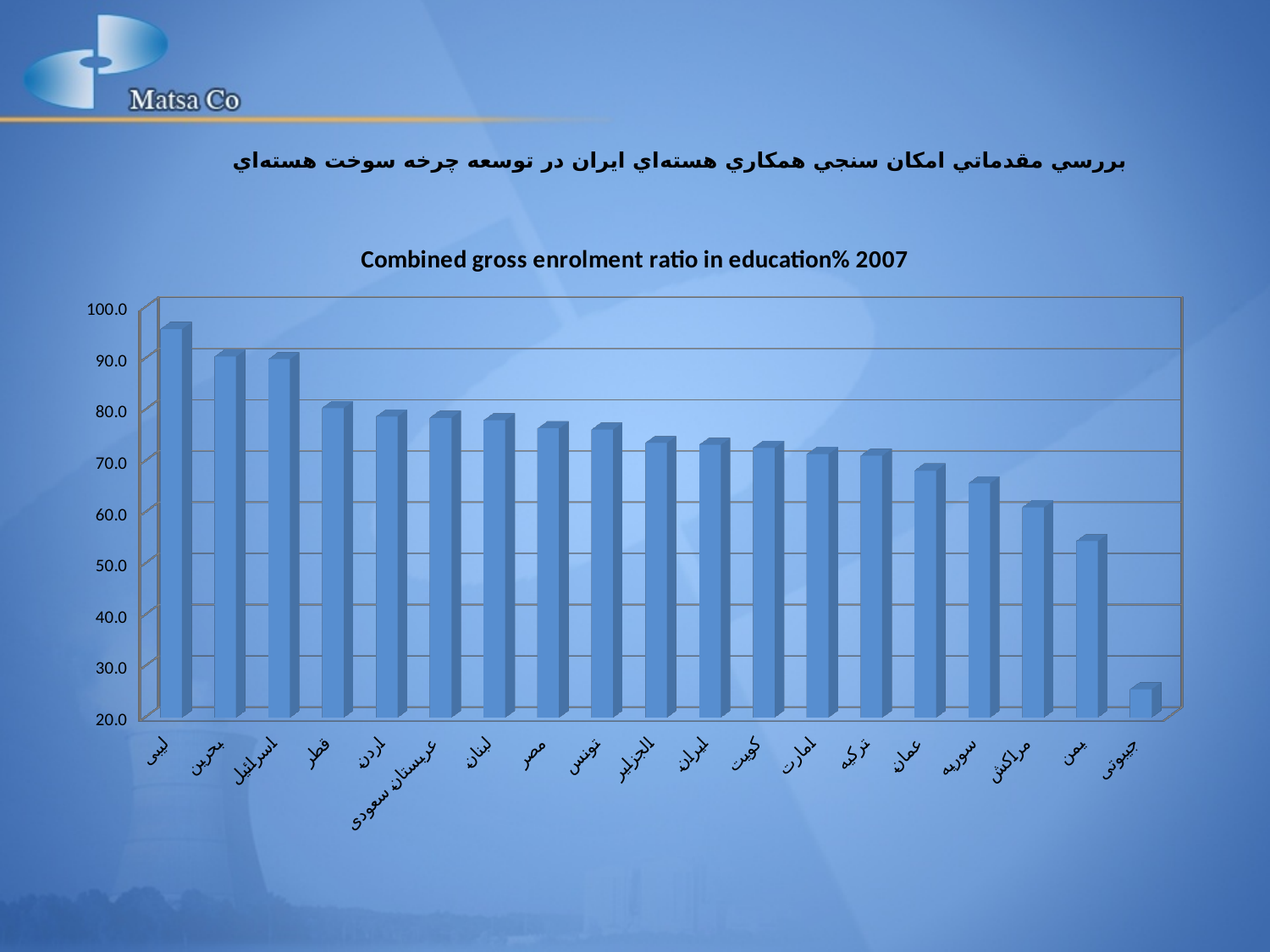
Is the value for عمان greater or less than 70? less Do the values generally rise or fall from left to right along the x axis? fall What kind of chart is shown on the slide? bar chart Is the value for جیبوتی greater or less than 30? less Is the value for لیبی greater or less than 90? greater What is the title of the chart? Combined gross enrolment ratio in education% 2007 Which country has the lowest combined gross enrolment ratio? جیبوتی How many countries are plotted in the chart? 19 Which has a higher value, قطر or سوریه? قطر Which country has the highest combined gross enrolment ratio? لیبی